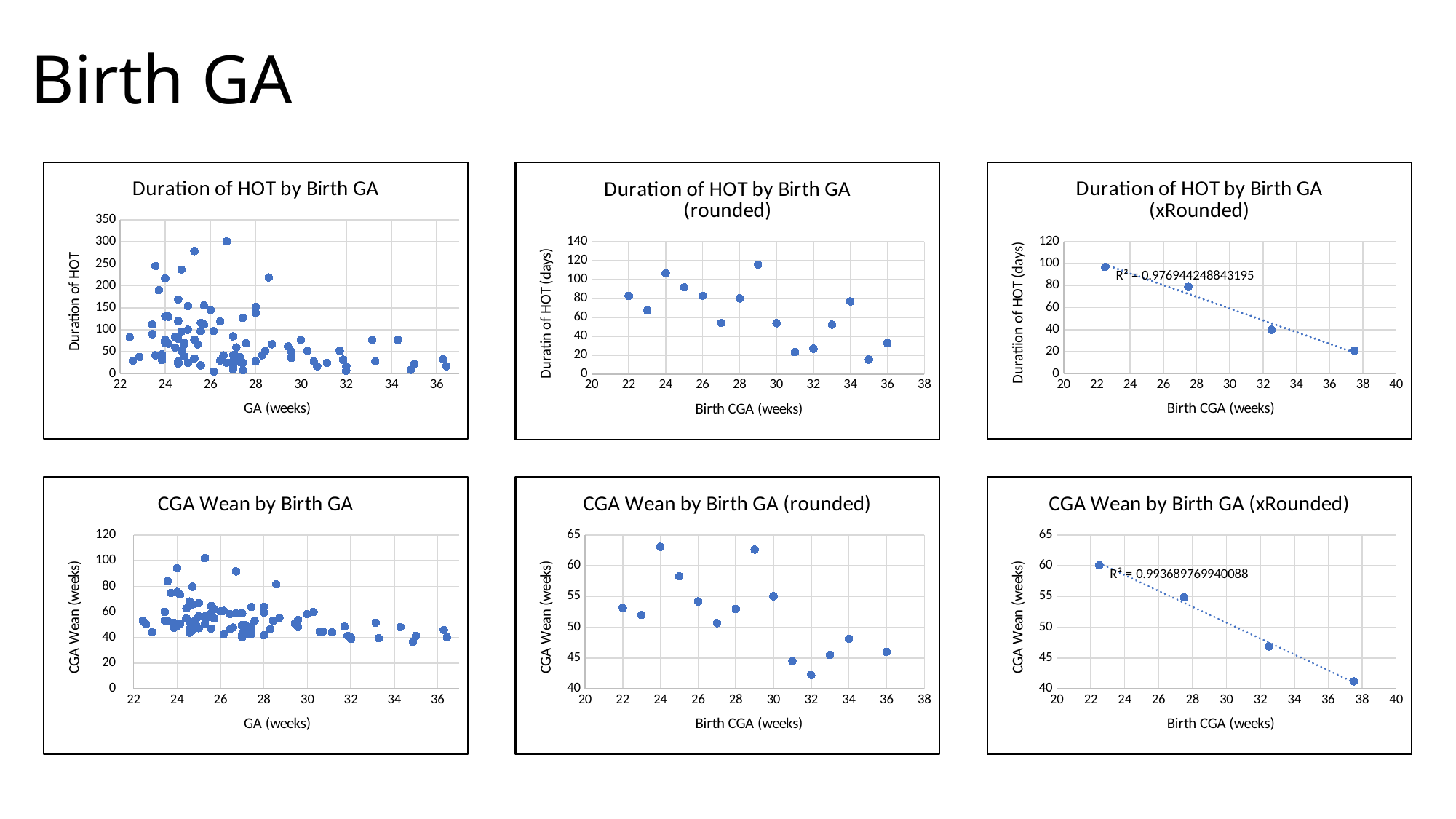
How many charts are shown on the slide? 6 What R² value is shown on the "Duration of HOT by Birth GA (xRounded)" chart? 0.976944248843195 In "CGA Wean by Birth GA (rounded)", is the value at Birth CGA 32 weeks greater or less than 45? less What R² value is shown on the "CGA Wean by Birth GA (xRounded)" chart? 0.993689769940088 In "Duration of HOT by Birth GA (rounded)", is the value at Birth CGA 35 weeks greater or less than 20? less What kind of chart is "Duration of HOT by Birth GA" (top left)? Scatter chart In "Duration of HOT by Birth GA (rounded)", how many data points are plotted? 15 In "Duration of HOT by Birth GA (rounded)", which has the larger duration of HOT: Birth CGA 22 weeks or 36 weeks? 22 weeks In "CGA Wean by Birth GA (xRounded)", how many data points are plotted? 4 In "CGA Wean by Birth GA (xRounded)", do the values rise or fall as Birth CGA increases? fall In "Duration of HOT by Birth GA (rounded)", at which Birth CGA is the duration of HOT highest? 29 In "Duration of HOT by Birth GA (rounded)", is the value at Birth CGA 29 weeks greater or less than 100? greater